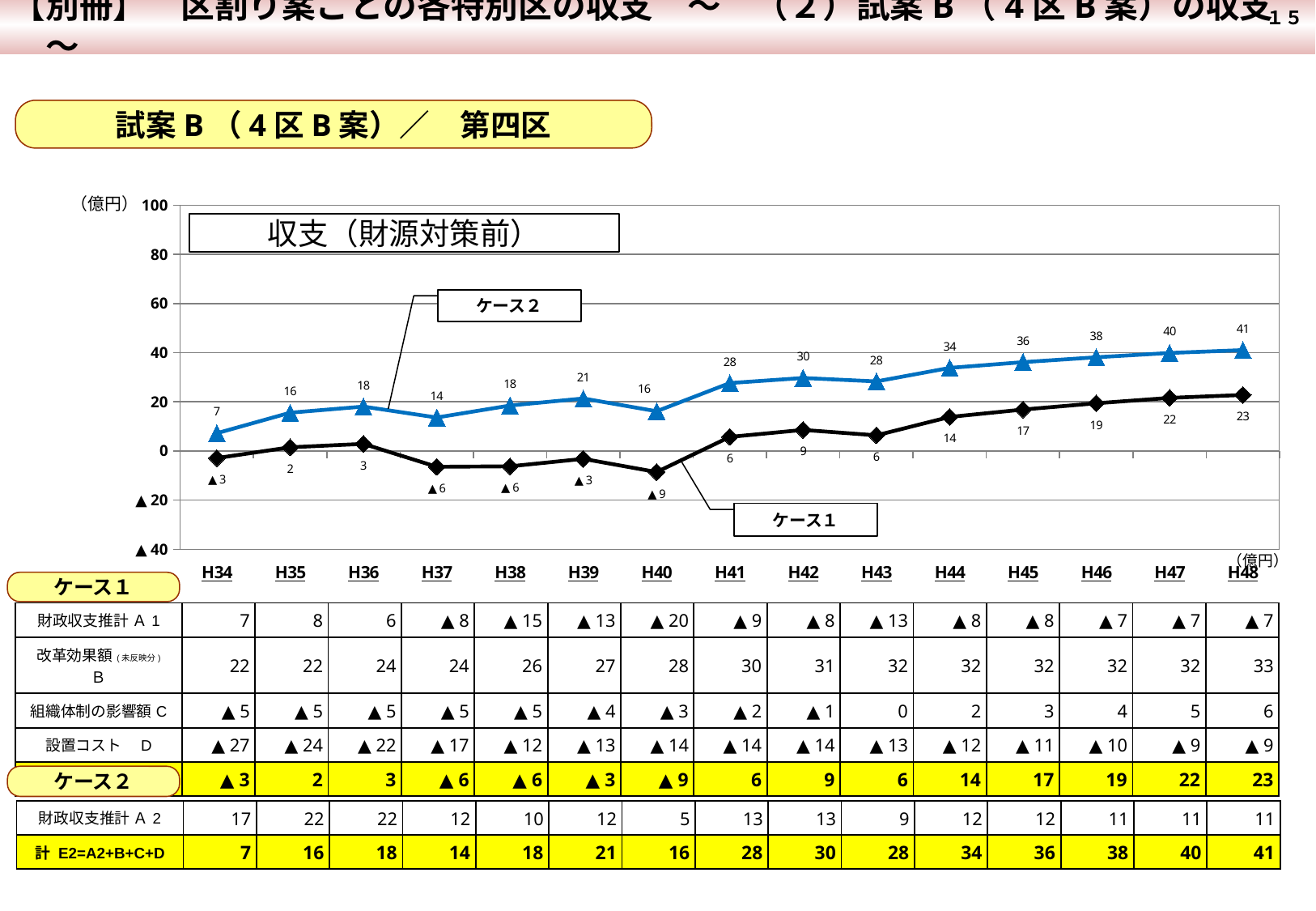
What is the title of the chart? 収支（財源対策前） Is the value of ケース2 at H45 greater or less than 20? greater Which series has the larger value at H42, ケース1 or ケース2? ケース2 Does the ケース2 line generally rise or fall from H41 to H48? rise What is the value of ケース2 at H41 in the chart? 28 What type of chart is shown on the slide? line chart How many data points (years) are plotted along the x axis of the chart? 15 At which year does ケース2 reach its highest value in the chart? H48 What is the value of ケース1 at H40 in the chart? ▲9 At which year does ケース2 have its lowest value in the chart? H34 What is the difference between the ケース2 value and the ケース1 value at H48? 18 What is the value of ケース1 at H45 in the chart? 17